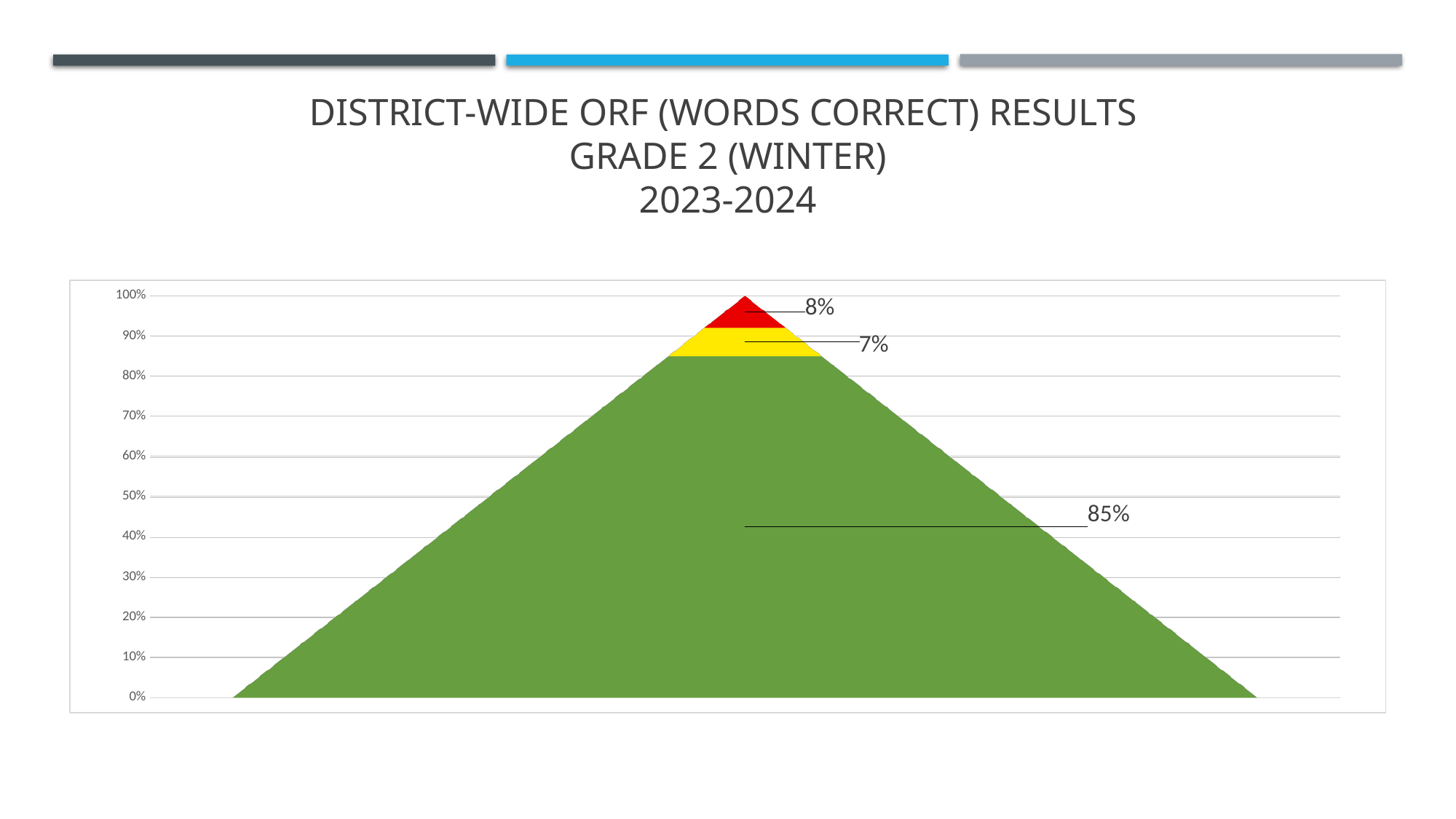
What is the title of the chart on the slide? District-Wide ORF (Words Correct) Results Grade 2 (Winter) 2023-2024 What kind of chart is shown on the slide? Stacked pyramid chart What percentage is shown for the yellow segment of the pyramid? 7% How many coloured segments make up the pyramid? 3 What percentage is shown for the red segment at the top of the pyramid? 8% What percentage is shown for the green segment of the pyramid? 85% Which is larger, the red segment or the yellow segment? Red Which coloured segment has the smallest percentage? Yellow What is the difference between the red segment's percentage and the yellow segment's percentage? 1% What is the difference between the green segment's percentage and the red segment's percentage? 77% Which coloured segment has the largest percentage? Green What is the total of the three segments in the pyramid? 100%